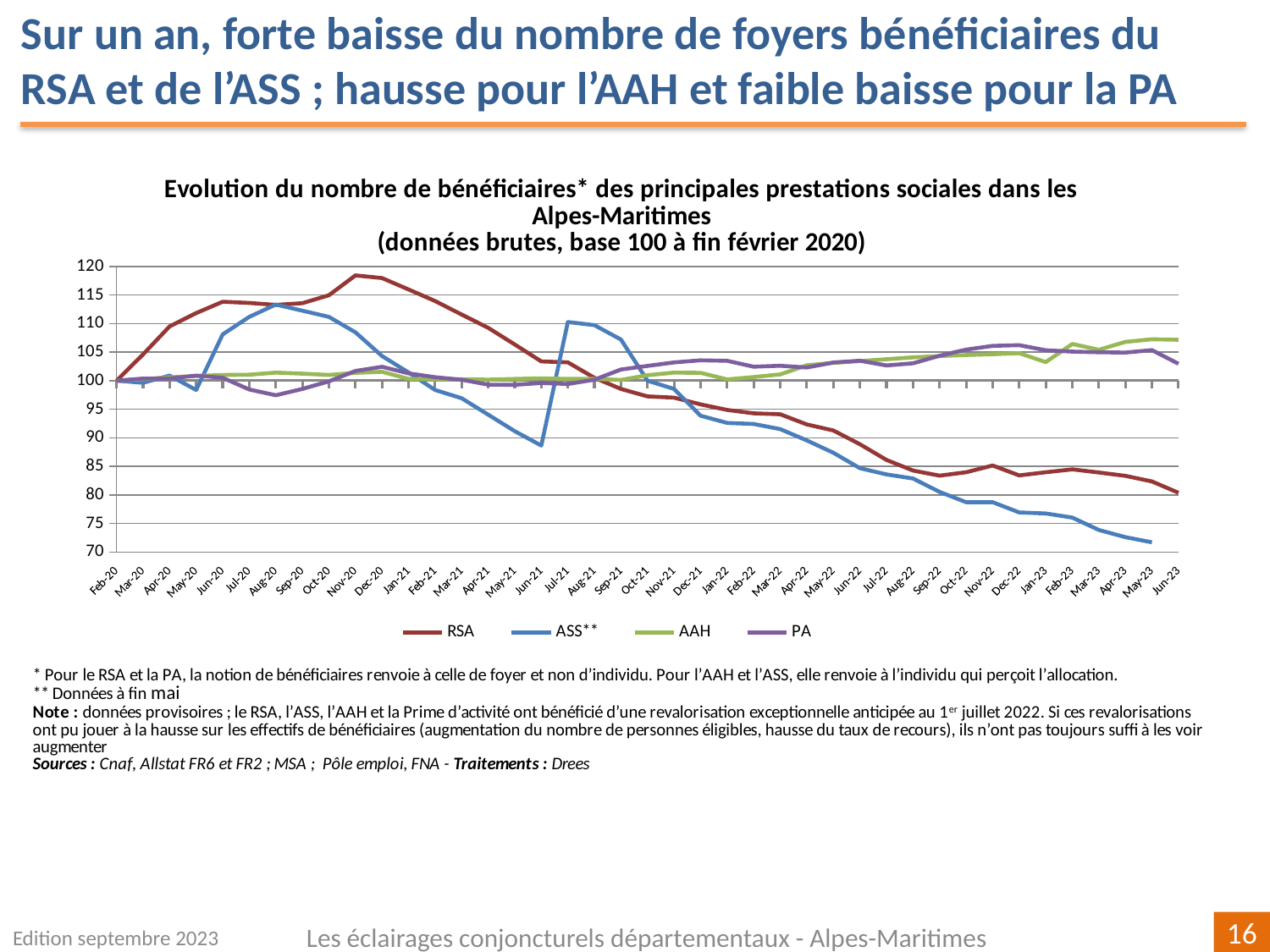
Is the value for RSA at Nov-20 greater or less than 115? greater Is the value for ASS** at May-23 greater or less than 75? less What kind of chart is shown on the slide? line chart Which series has the lowest value at the end of the period shown? ASS** How many series does the legend list? 4 Is the value for PA at Aug-20 greater or less than 100? less Which series has the highest value at Jun-23? AAH What base value and date does the chart title say the data are indexed to? base 100 à fin février 2020 Which is larger at Nov-20, the value for RSA or the value for ASS**? RSA Does the RSA series rise or fall between Nov-20 and Jun-23? fall